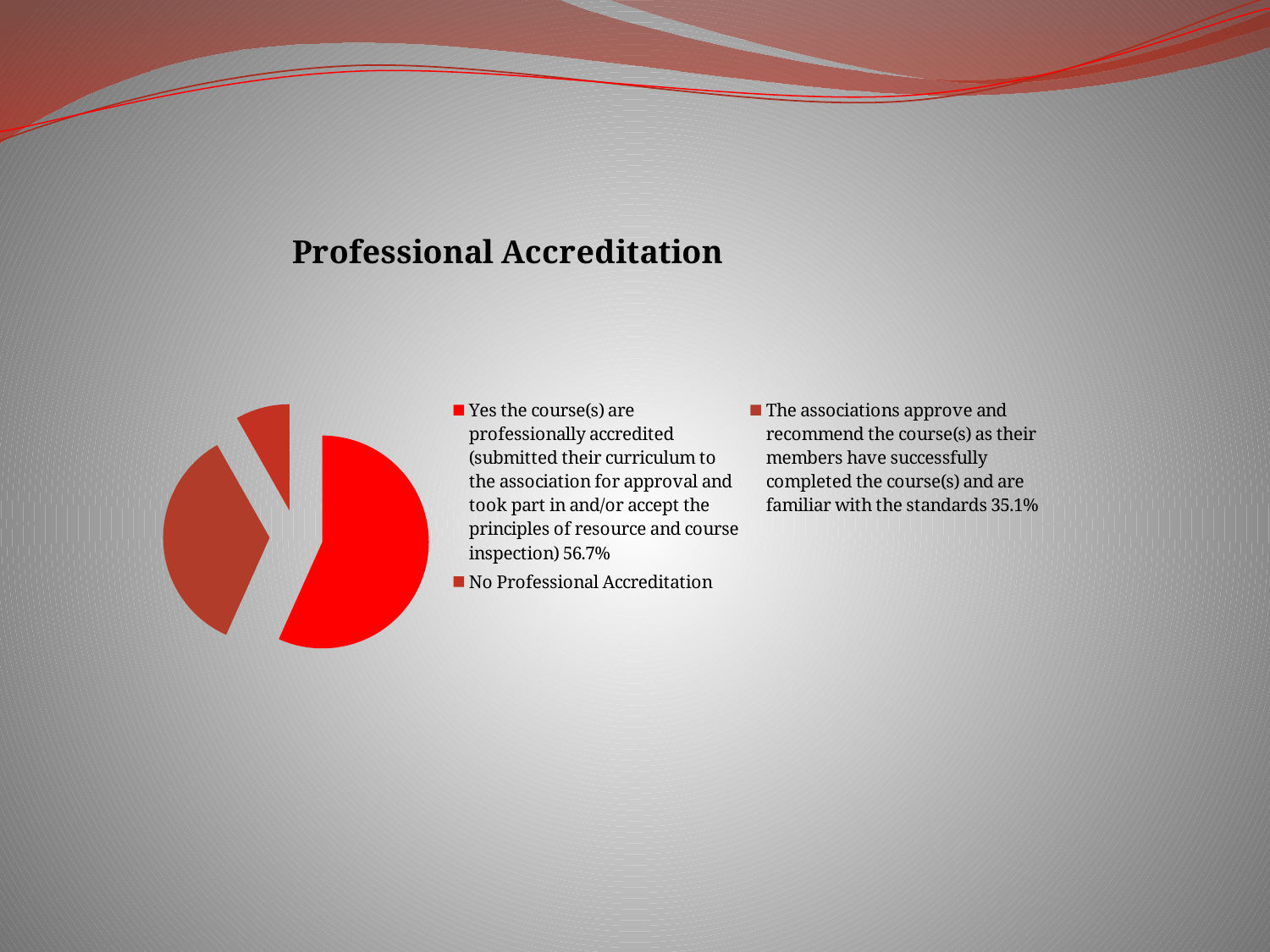
Which category has the largest share of the pie? Yes the course(s) are professionally accredited Which is larger: the share for courses that are professionally accredited or the share for associations approving and recommending the course(s)? Yes the course(s) are professionally accredited What percentage is shown for courses that are professionally accredited (submitted their curriculum to the association for approval)? 56.7% What is the difference in percentage points between the professionally accredited share (56.7%) and the associations approve and recommend share (35.1%)? 21.6 How many entries does the chart legend list? 3 What kind of chart is shown on the slide? pie chart How many slices does the pie chart have? 3 Is the share for 'No Professional Accreditation' larger or smaller than the share for 'The associations approve and recommend the course(s)'? smaller What percentage is shown for the associations approving and recommending the course(s) because their members have completed them? 35.1% What is the title of the chart? Professional Accreditation Which category has the smallest share of the pie? No Professional Accreditation